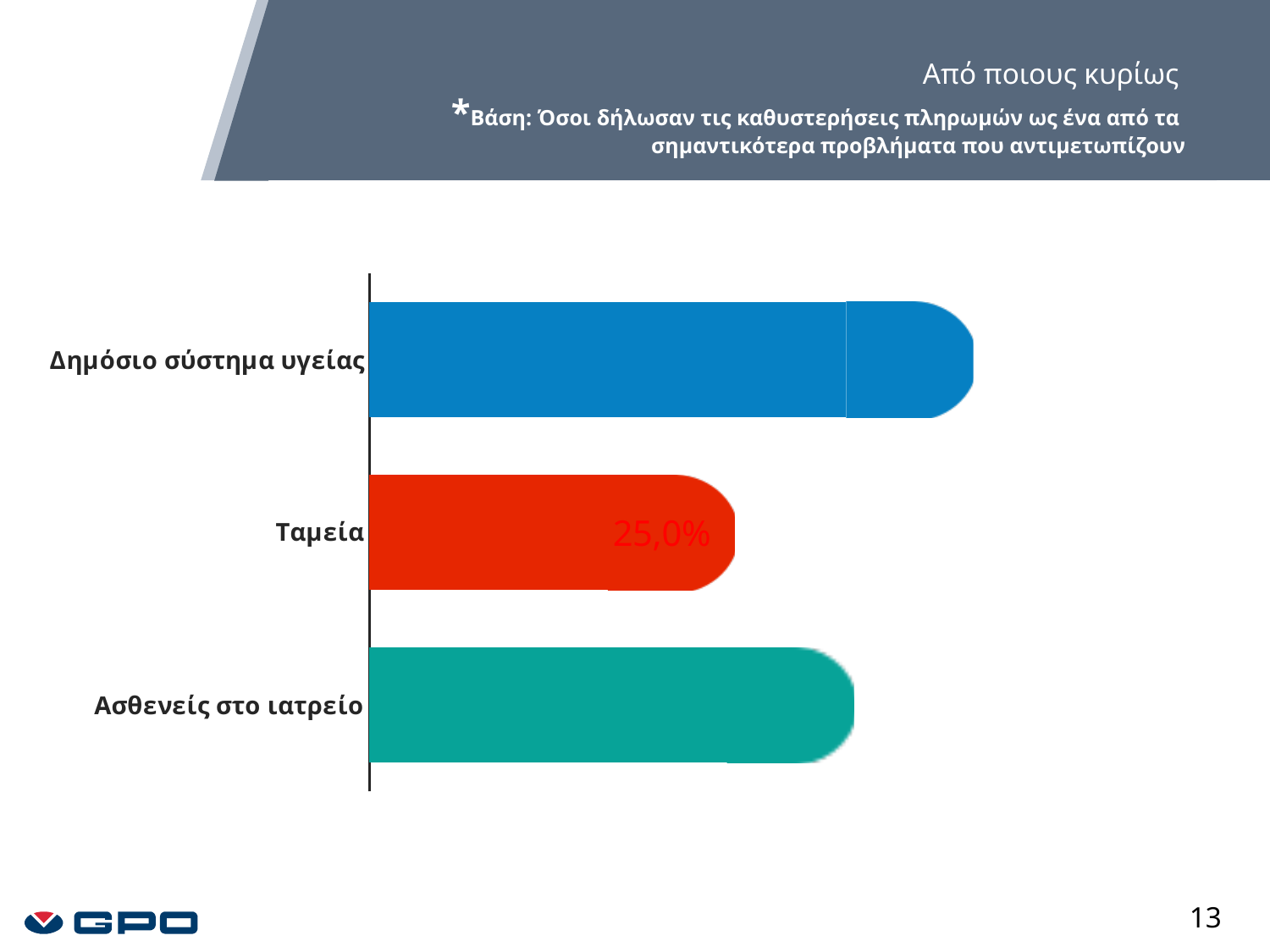
What value is shown for Ταμεία? 25,0% What colour is the bar for Ταμεία? Red How many categories are shown in the chart? 3 Which is larger, the value for Δημόσιο σύστημα υγείας or the value for Ασθενείς στο ιατρείο? Δημόσιο σύστημα υγείας Which category has the longest bar? Δημόσιο σύστημα υγείας What kind of chart is shown on the slide? Bar chart Which is larger, the value for Ασθενείς στο ιατρείο or the value for Ταμεία? Ασθενείς στο ιατρείο What is the title shown at the top of the slide? Από ποιους κυρίως Which category has the shortest bar? Ταμεία